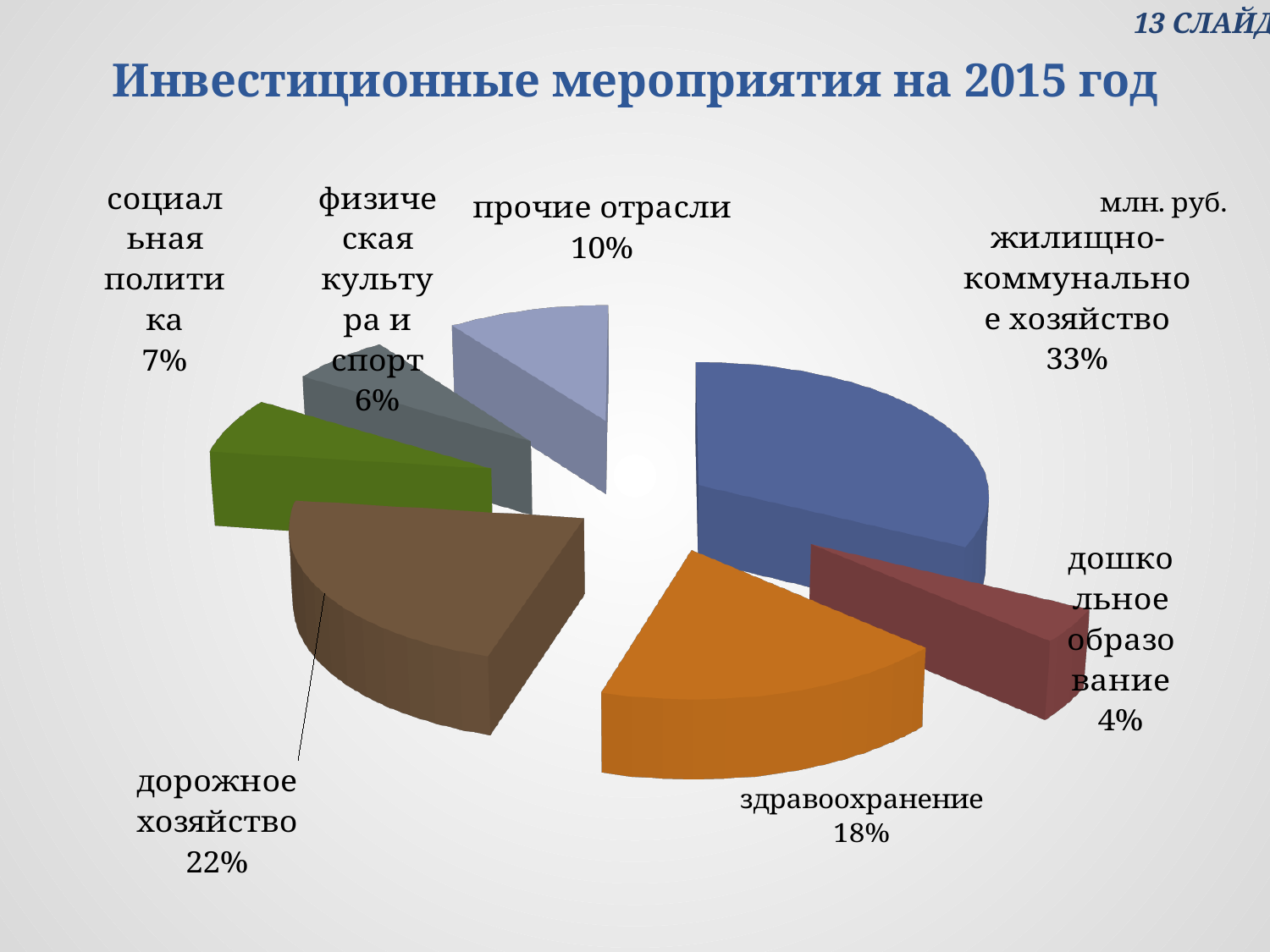
Что больше: доля социальной политики или доля физической культуры и спорта? социальная политика Какой тип диаграммы показан на слайде? Круговая диаграмма Какая отрасль имеет наименьшую долю на диаграмме? дошкольное образование Какова доля дорожного хозяйства на диаграмме? 22% На сколько процентных пунктов доля дорожного хозяйства больше доли здравоохранения? 4 Какая отрасль имеет наибольшую долю на диаграмме? жилищно-коммунальное хозяйство Какова суммарная доля прочих отраслей и социальной политики? 17% Какова доля здравоохранения на диаграмме? 18% Сколько секторов (отраслей) показано на диаграмме? 7 Какова доля жилищно-коммунального хозяйства в инвестиционных мероприятиях на 2015 год? 33% Какова доля дошкольного образования на диаграмме? 4% Какая единица измерения указана на диаграмме? млн. руб.